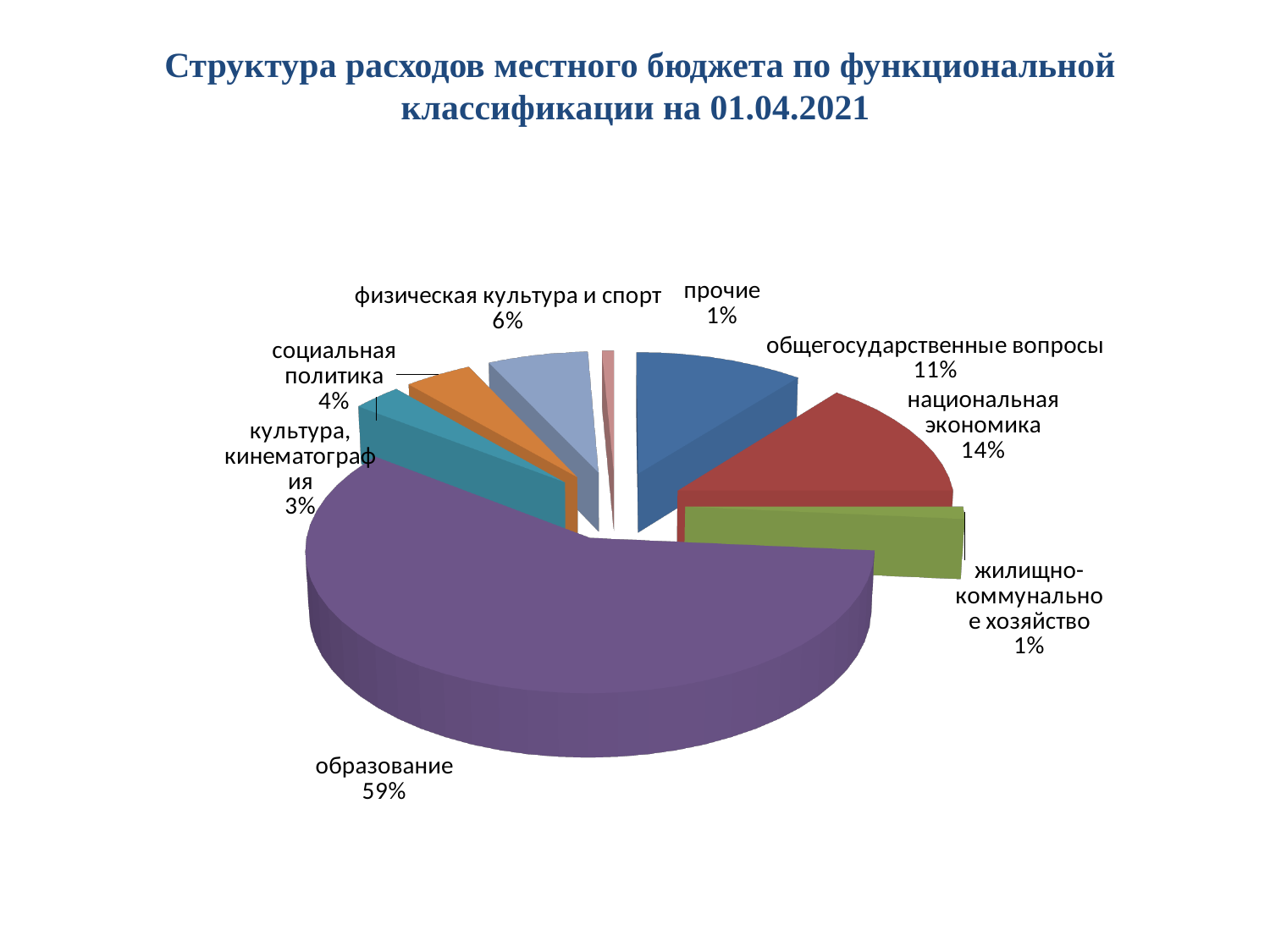
How many categories (slices) does the pie chart show? 8 Which category has the largest share of the pie? образование Which is larger, the share for социальная политика or the share for культура, кинематография? социальная политика What is the difference between the shares of национальная экономика and общегосударственные вопросы? 3% What is the value shown for социальная политика? 4% What is the value shown for общегосударственные вопросы? 11% What share of the pie does образование account for? 59% What is the value shown for физическая культура и спорт? 6% What is the value shown for национальная экономика? 14% What kind of chart is shown on the slide? pie chart What is the title of the chart on the slide? Структура расходов местного бюджета по функциональной классификации на 01.04.2021 What is the difference between the shares of образование and национальная экономика? 45%